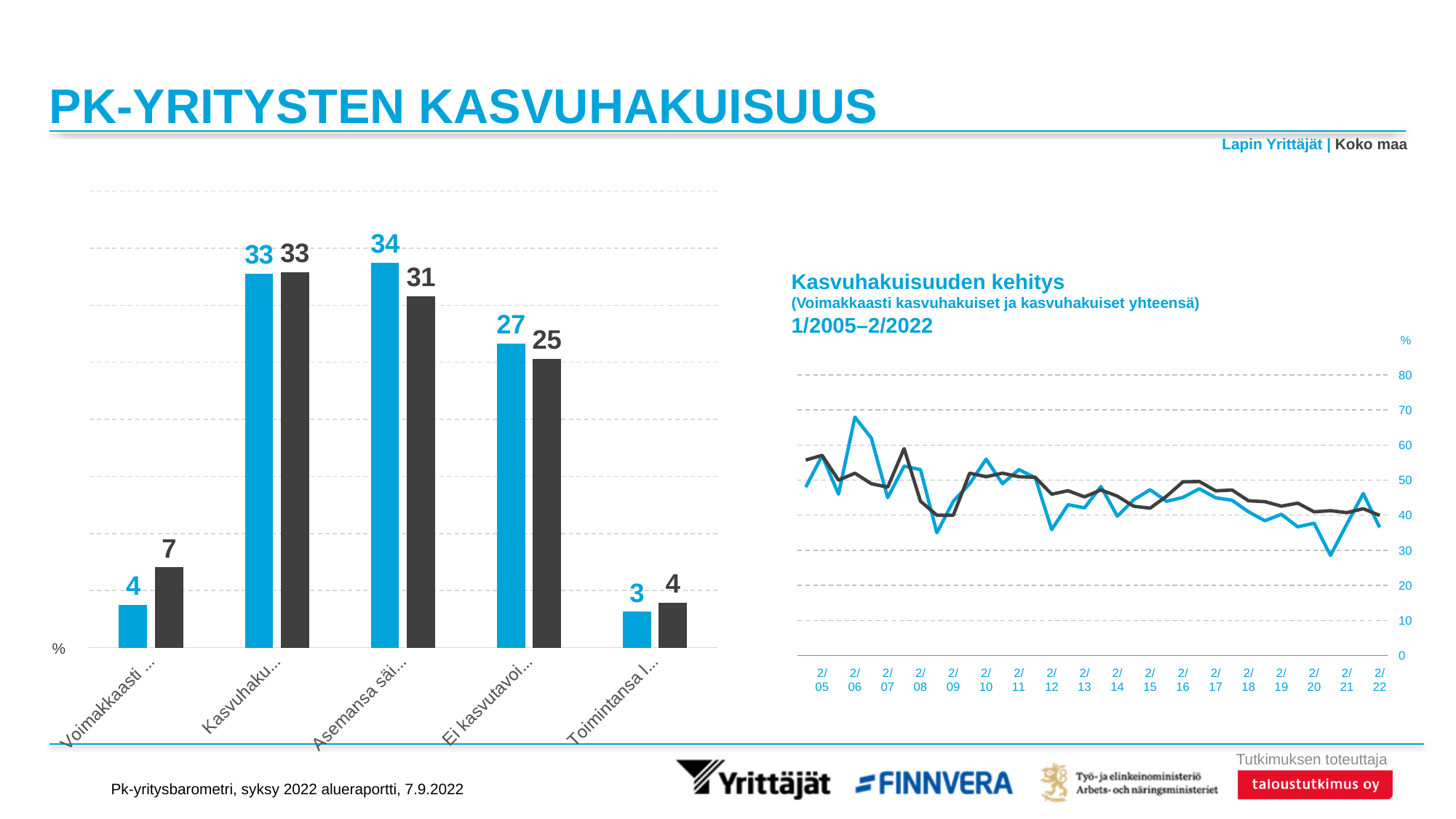
In the bar chart on the left, which is larger in the first category ("Voimakkaasti ..."): the Lapin Yrittäjät value or the Koko maa value? Koko maa How many series does the bar chart on the left compare? 2 What type of chart is the "Kasvuhakuisuuden kehitys" chart on the right? Line chart In the bar chart on the left, which category has the lowest value for Lapin Yrittäjät? Toimintansa l... (the fifth category) In the bar chart on the left, what is the difference between the Lapin Yrittäjät and Koko maa values in the third category ("Asemansa säi...")? 3 In the bar chart on the left, which category has the highest value for Lapin Yrittäjät? Asemansa säi... (the third category) In the bar chart on the left, what is the value for Koko maa in the fourth category ("Ei kasvutavoi...")? 25 How many categories does the bar chart on the left show? 5 In the "Kasvuhakuisuuden kehitys" chart, is the value of the blue line at 2/06 greater or less than 60? greater In the "Kasvuhakuisuuden kehitys" chart, what period does the subtitle say the data covers? 1/2005–2/2022 In the bar chart on the left, what is the value for Koko maa in the first category ("Voimakkaasti ...")? 7 In the bar chart on the left, what is the value for Lapin Yrittäjät in the third category ("Asemansa säi...")? 34